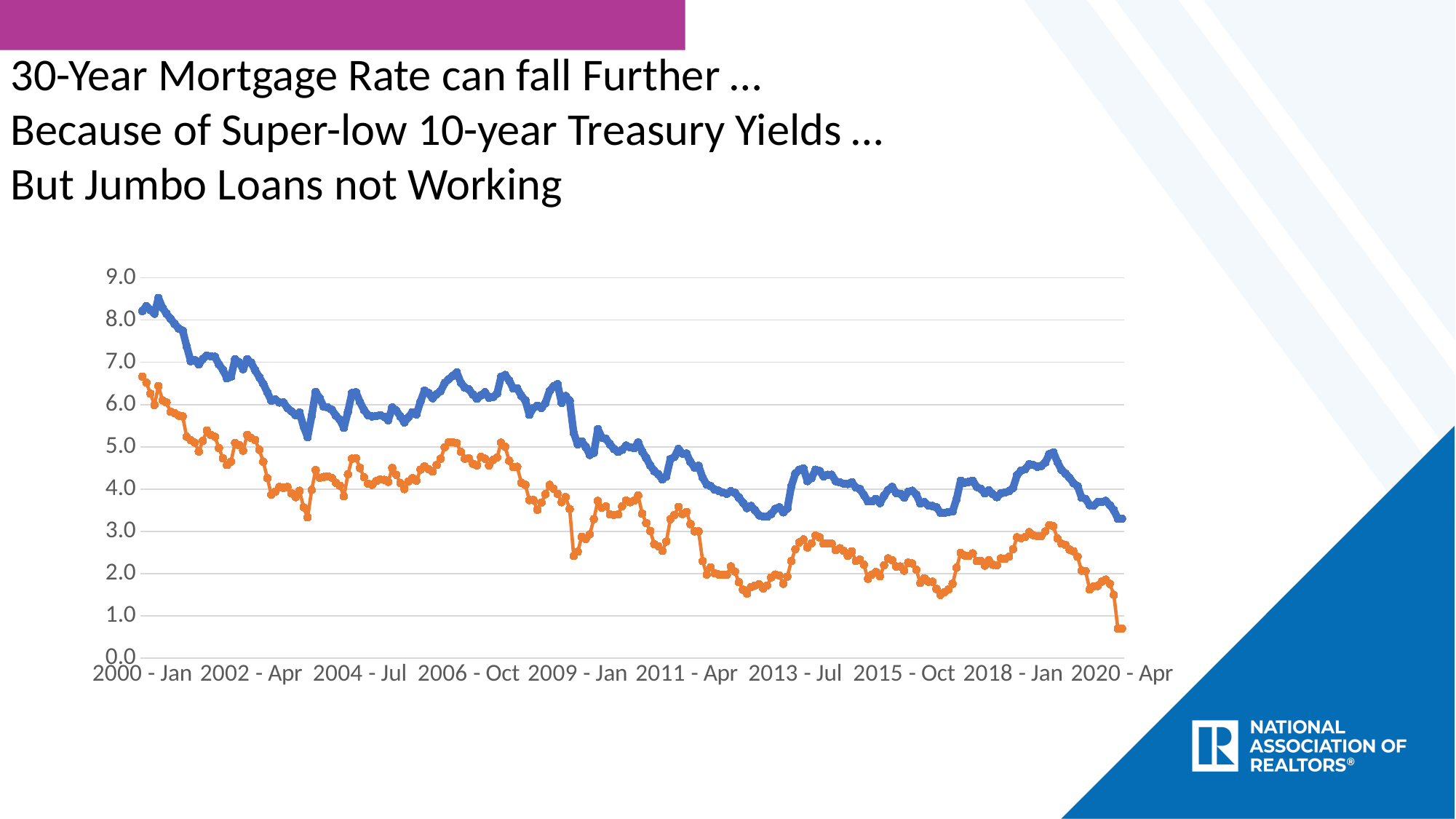
Is the value of the blue line at 2020 - Apr greater or less than 4.0? less Is the value of the orange line at 2020 - Apr greater or less than 1.0? less Which line is higher throughout the chart, the blue line or the orange line? blue line What kind of chart is shown on the slide? line chart What is the last label shown on the x axis? 2020 - Apr How many lines are plotted on the chart? 2 What is the highest value shown on the y axis? 9.0 What is the overall trend of the blue line from 2000 - Jan to 2020 - Apr? falling Is the value of the orange line at 2013 - Jul greater or less than 3.0? less What is the overall trend of the orange line across the x axis? falling